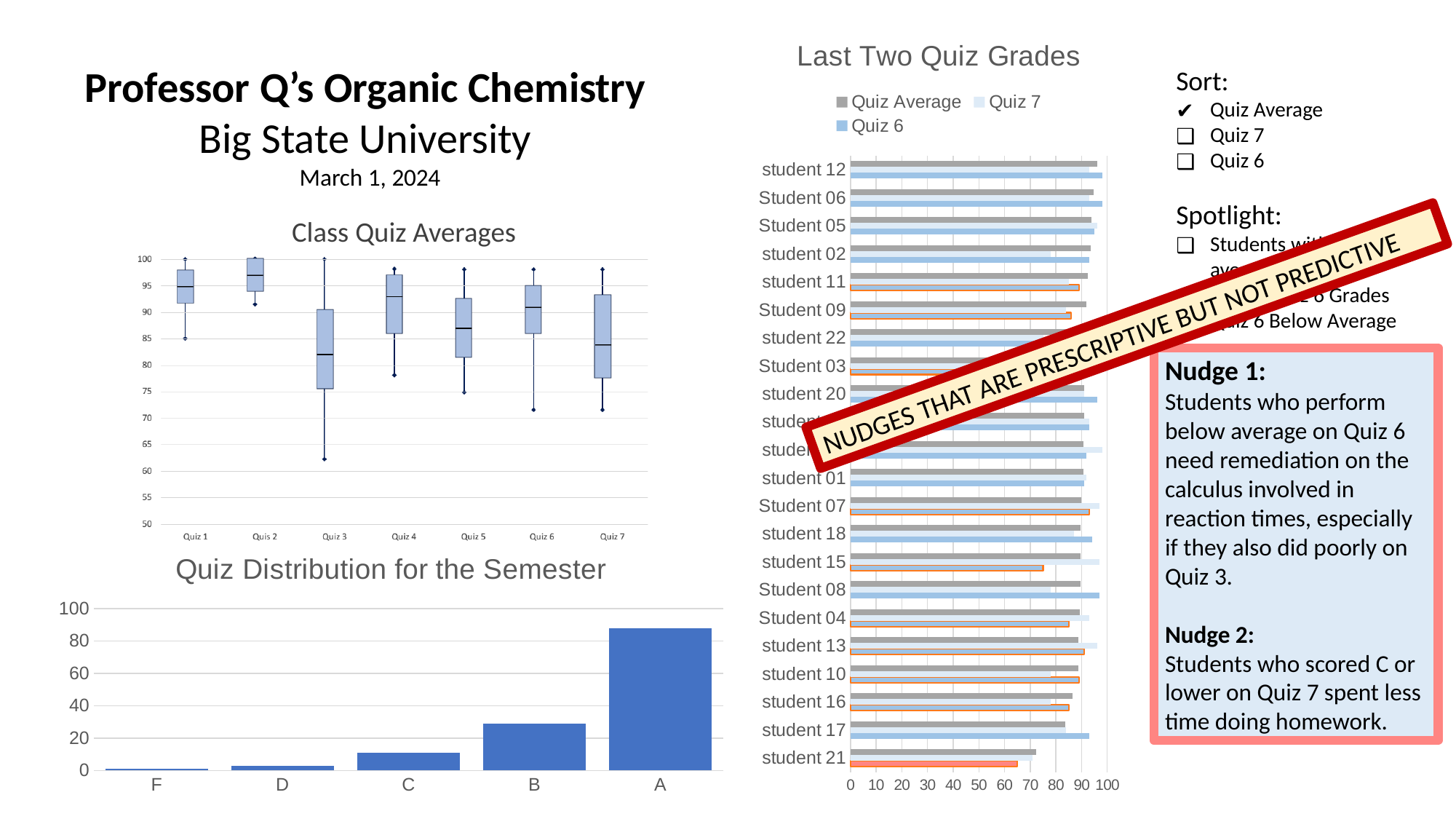
In the "Quiz Distribution for the Semester" chart, is the value for A greater or less than 80? greater In the "Quiz Distribution for the Semester" chart, how many grade categories are shown on the x axis? 5 In the "Quiz Distribution for the Semester" chart, is the value for C greater or less than 20? less In the "Class Quiz Averages" chart, how many quizzes are shown on the x axis? 7 In the "Last Two Quiz Grades" chart, is the Quiz 6 value for student 12 greater or less than 90? greater In the "Class Quiz Averages" chart, which quiz has the lowest minimum score (lowest whisker)? Quiz 3 In the "Quiz Distribution for the Semester" chart, which grade has the highest bar? A In the "Quiz Distribution for the Semester" chart, do the values rise or fall moving from F to A along the x axis? rise What kind of chart is the "Quiz Distribution for the Semester" chart? bar chart In the "Quiz Distribution for the Semester" chart, which grade has the lowest bar? F How many series does the legend of the "Last Two Quiz Grades" chart list? 3